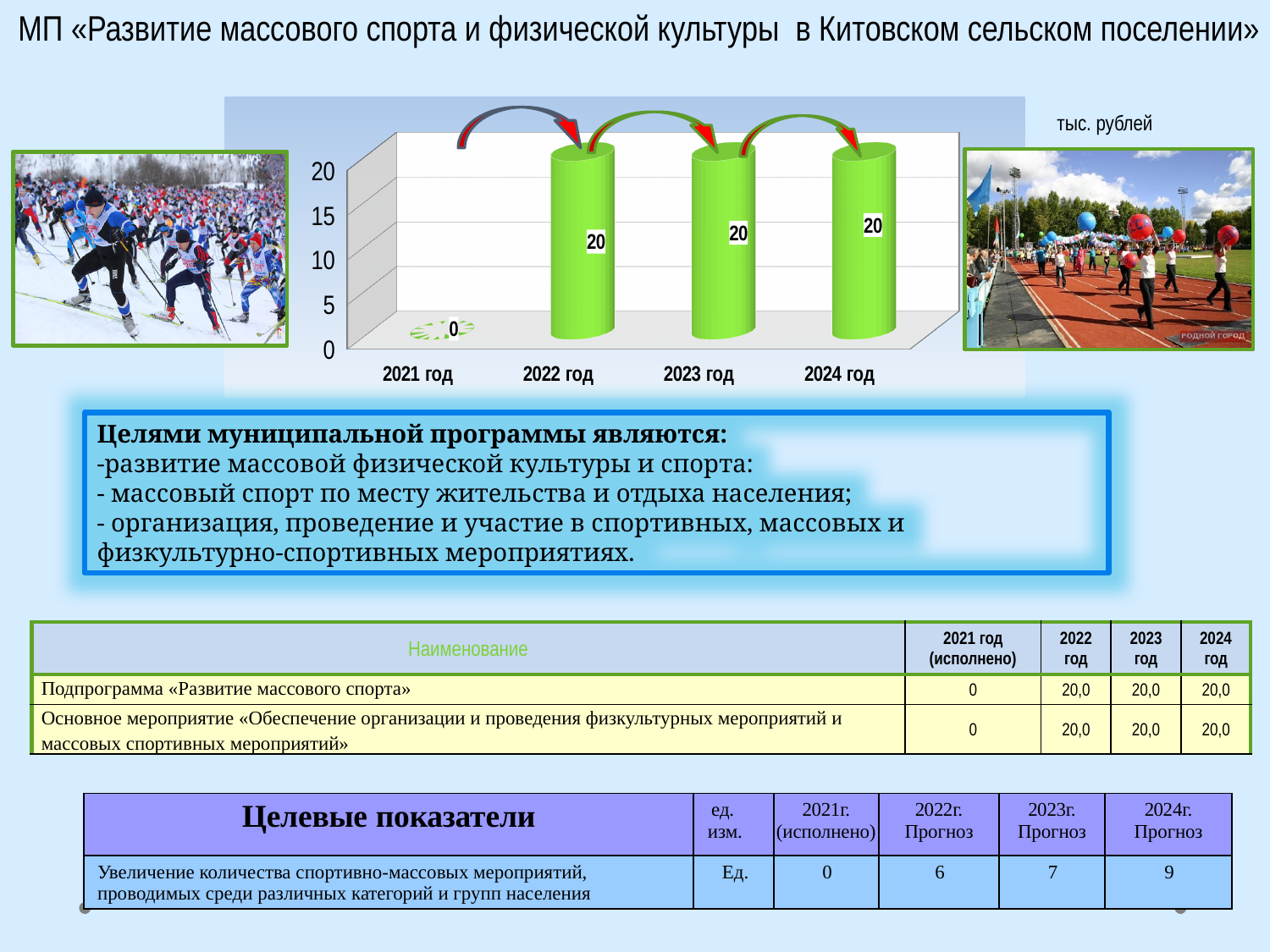
What is the difference between the values for 2022 год and 2021 год? 20 What kind of chart is shown on the slide? bar chart Is the value for 2023 год greater or less than 10? greater Which is larger, the value for 2021 год or the value for 2023 год? 2023 год Do the values rise or fall from 2021 год to 2022 год? rise What is the value for 2021 год in the chart? 0 What is the value for 2024 год in the chart? 20 What is the value for 2022 год in the chart? 20 What unit is indicated next to the chart? тыс. рублей Which year has the lowest value in the chart? 2021 год How many categories (years) are shown on the x axis of the chart? 4 What is the highest tick value shown on the chart's vertical axis? 20